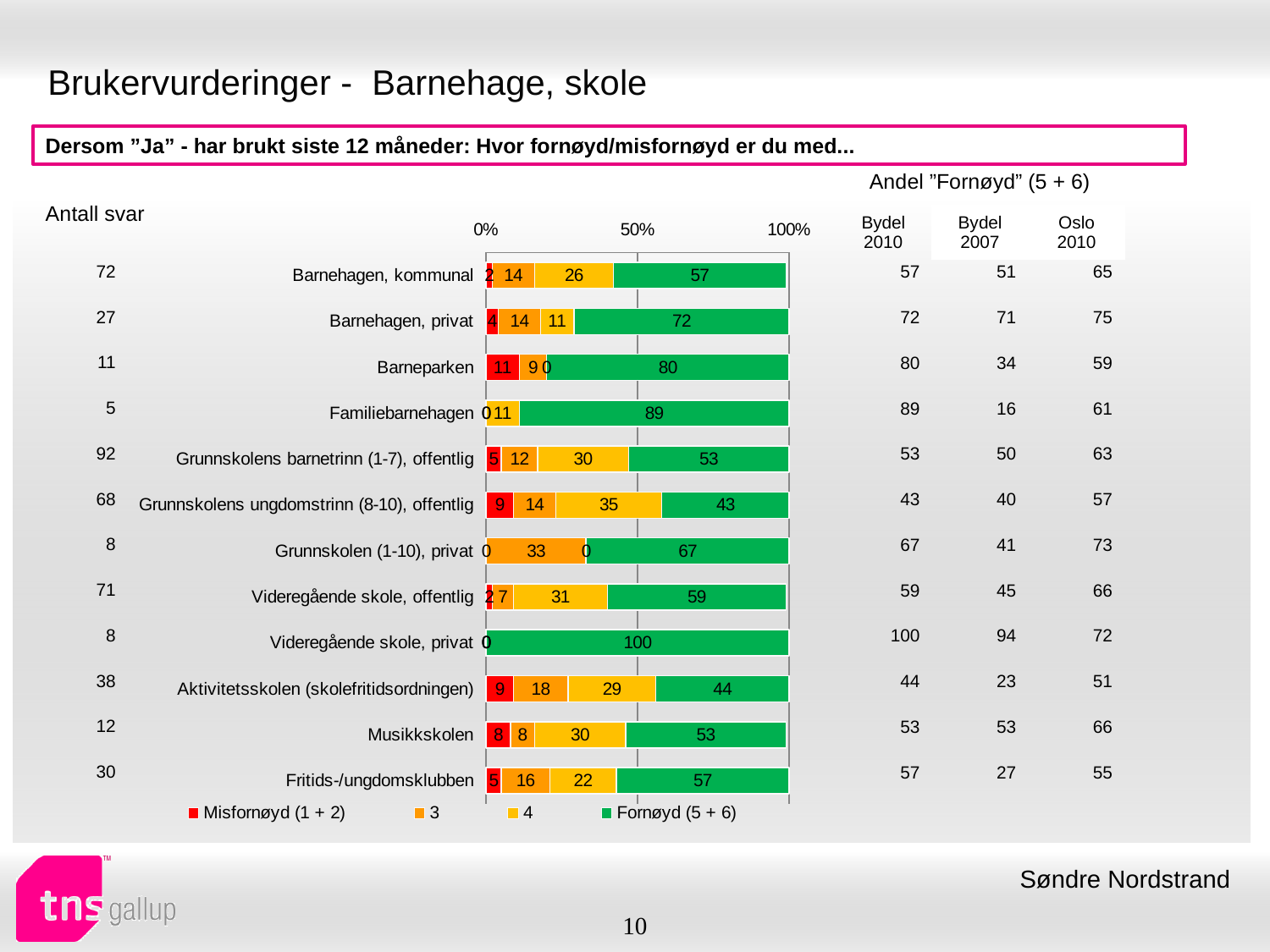
How many categories are shown in the chart? 12 What is the Fornøyd (5 + 6) value for Musikkskolen? 53 How many series does the legend list? 4 What is the Misfornøyd (1 + 2) value for Barneparken? 11 Which category has the lowest Fornøyd (5 + 6) value? Grunnskolens ungdomstrinn (8-10), offentlig What is the value of series 4 for Grunnskolens ungdomstrinn (8-10), offentlig? 35 What kind of chart is shown on the slide? Stacked bar chart Which has a larger Fornøyd (5 + 6) value, Aktivitetsskolen (skolefritidsordningen) or Fritids-/ungdomsklubben? Fritids-/ungdomsklubben What is the difference between the Fornøyd (5 + 6) values for Barnehagen, privat and Barnehagen, kommunal? 15 What is the value of series 3 for Grunnskolen (1-10), privat? 33 What colour represents the Fornøyd (5 + 6) series? Green Which category has the highest Fornøyd (5 + 6) value? Videregående skole, privat